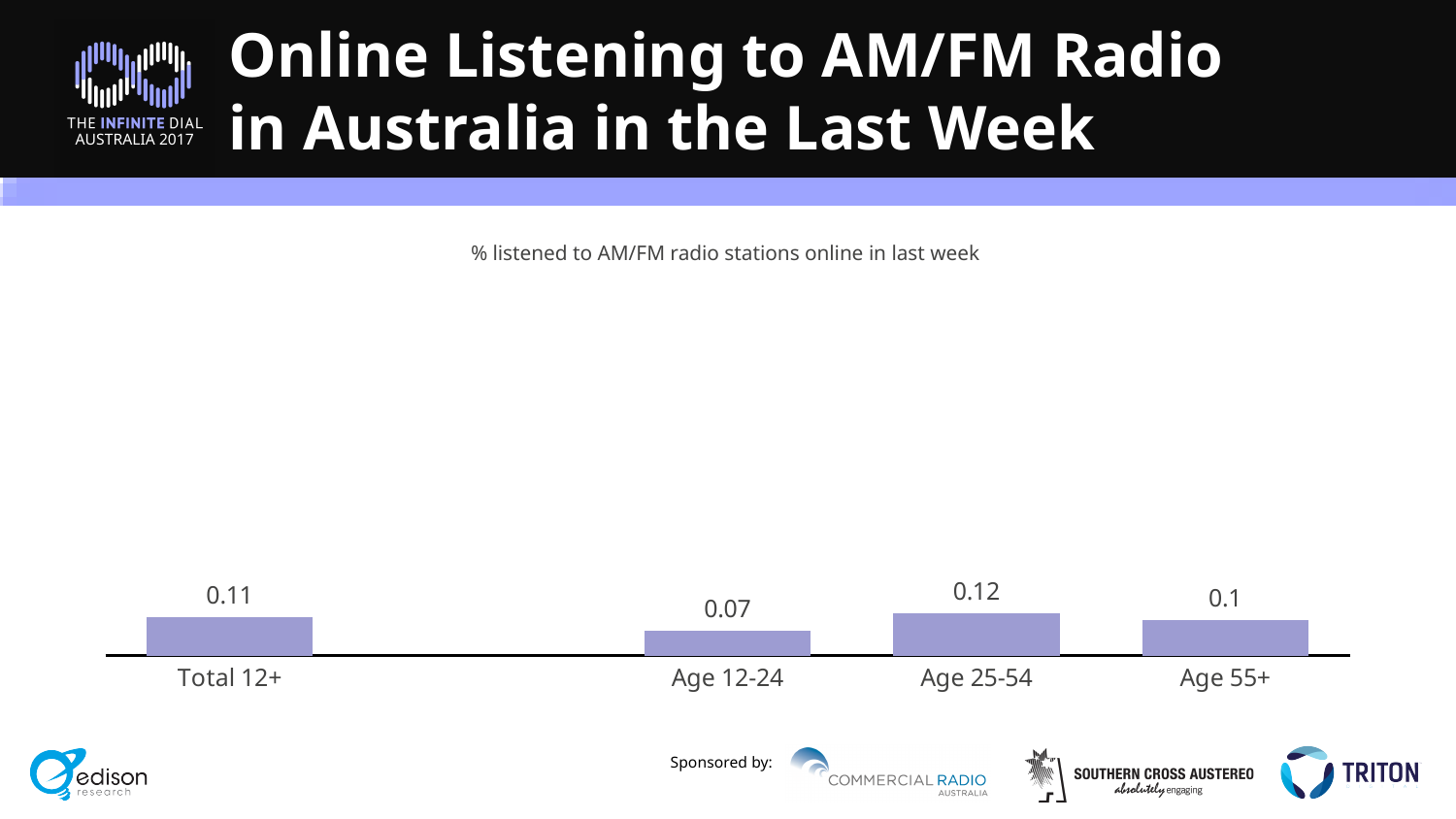
What is the value for Age 25-54? 0.12 What is the subtitle text shown above the chart? % listened to AM/FM radio stations online in last week What is the difference between the values for Total 12+ and Age 12-24? 0.04 Which category has the highest value? Age 25-54 What kind of chart is shown on the slide? Bar chart Which is larger, the value for Total 12+ or the value for Age 55+? Total 12+ How many categories are shown in the chart? 4 What is the value for Age 55+? 0.1 What is the difference between the values for Age 25-54 and Age 12-24? 0.05 What is the value for Total 12+? 0.11 Which category has the lowest value? Age 12-24 What is the value for Age 12-24? 0.07